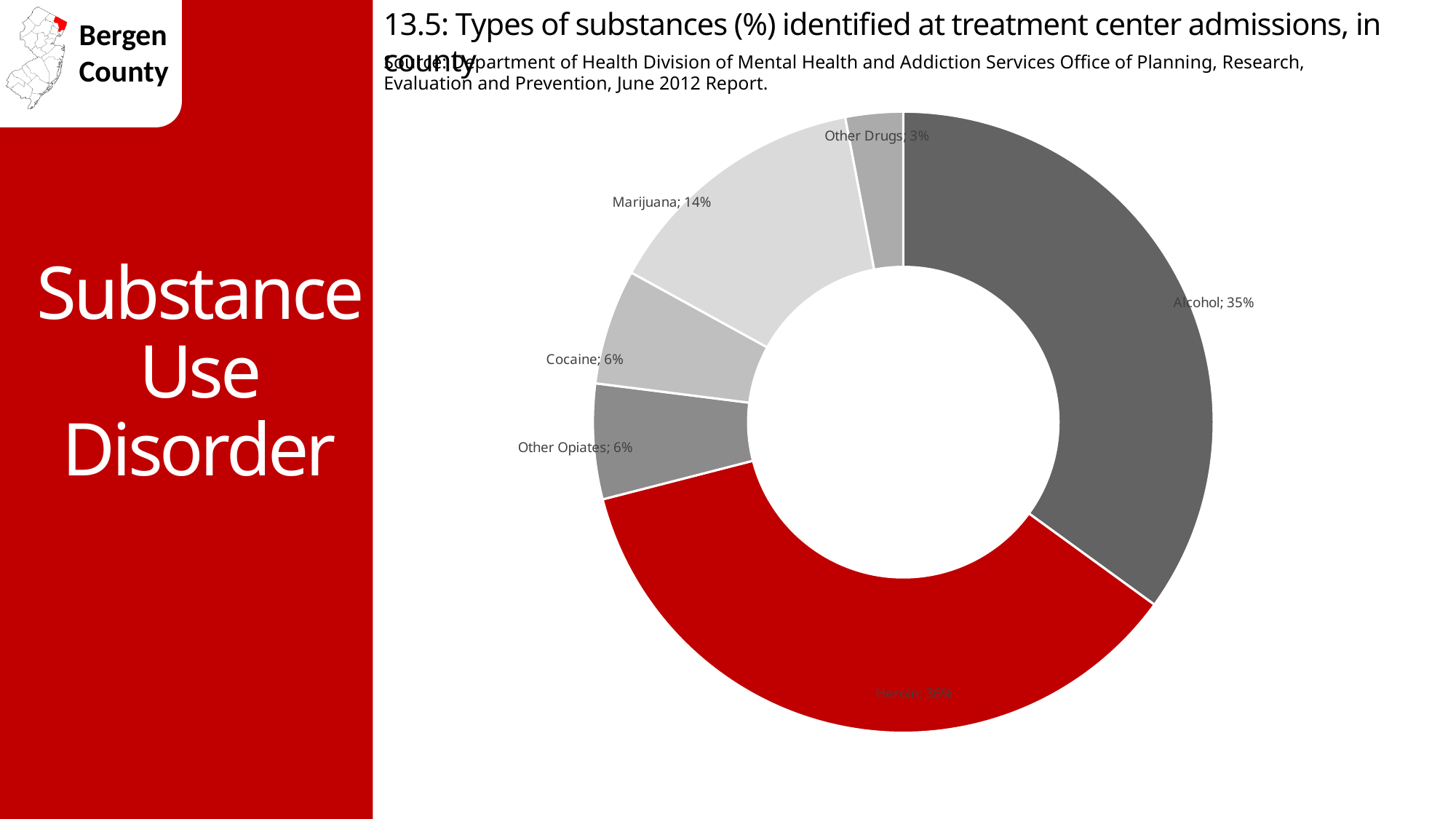
What percentage is shown for Cocaine? 6% What percentage is shown for Other Opiates? 6% What percentage is shown for Other Drugs? 3% What kind of chart is shown on the slide? Pie chart (doughnut) What percentage is shown for Heroin? 36% What percentage of treatment center admissions is attributed to Alcohol? 35% What percentage is shown for Marijuana? 14% Which substance has the largest share of admissions? Heroin How many substance categories are shown in the chart? 6 Which substance has the smallest share of admissions? Other Drugs Which has a larger share, Marijuana or Cocaine? Marijuana What is the difference in percentage points between Alcohol and Marijuana? 21